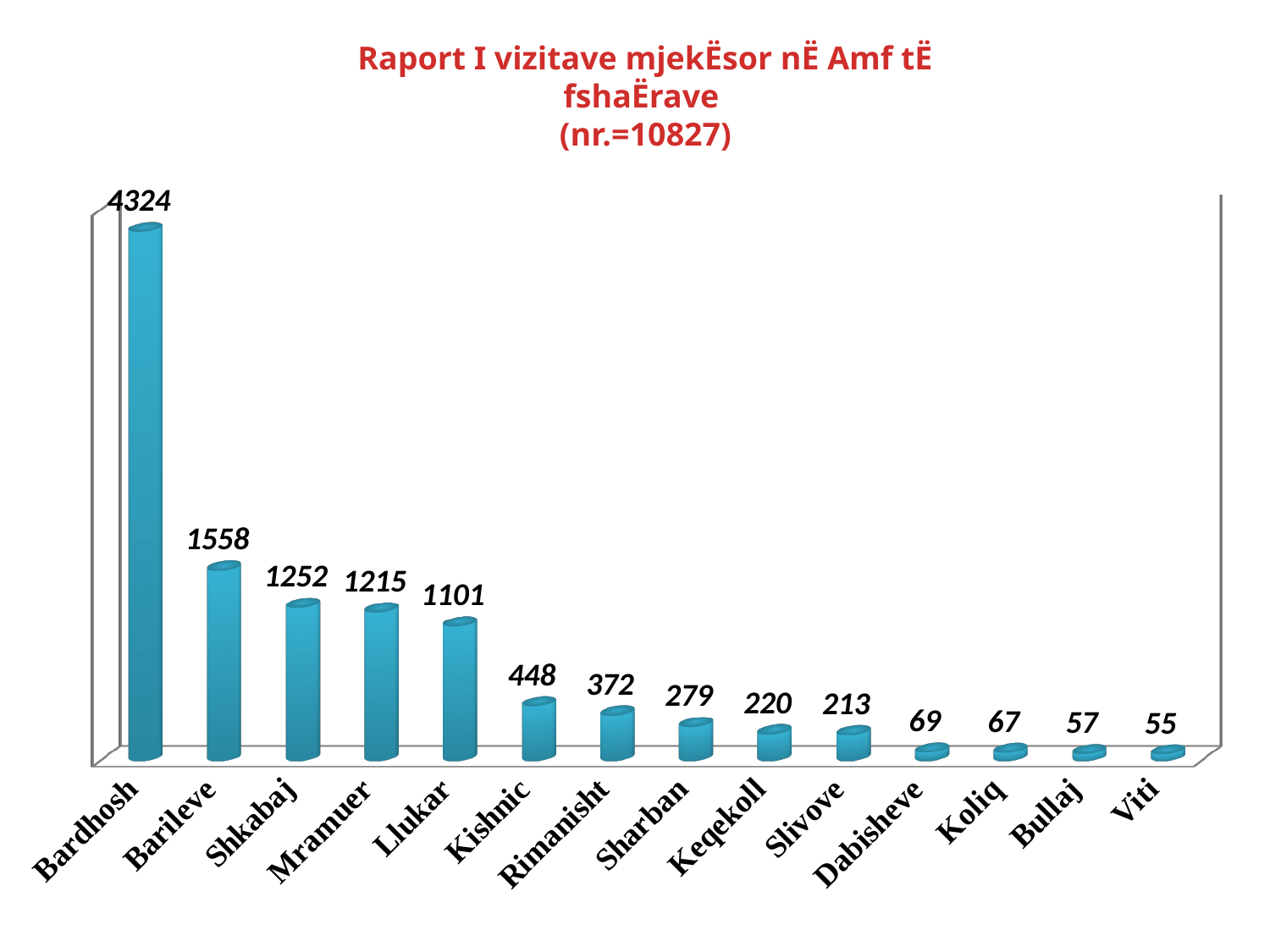
Do the values rise or fall from left to right along the x axis? fall What is the difference between the values for Bardhosh and Llukar? 3223 What is the difference between the values for Barileve and Shkabaj? 306 What kind of chart is this? bar chart What is the value for Bardhosh? 4324 What is the value for Kishnic? 448 What total number is given in the chart title? 10827 Which category has the highest value? Bardhosh Which category has the lowest value? Viti What is the value for Dabisheve? 69 Which is larger, the value for Rimanisht or the value for Sharban? Rimanisht How many categories are shown on the x axis? 14